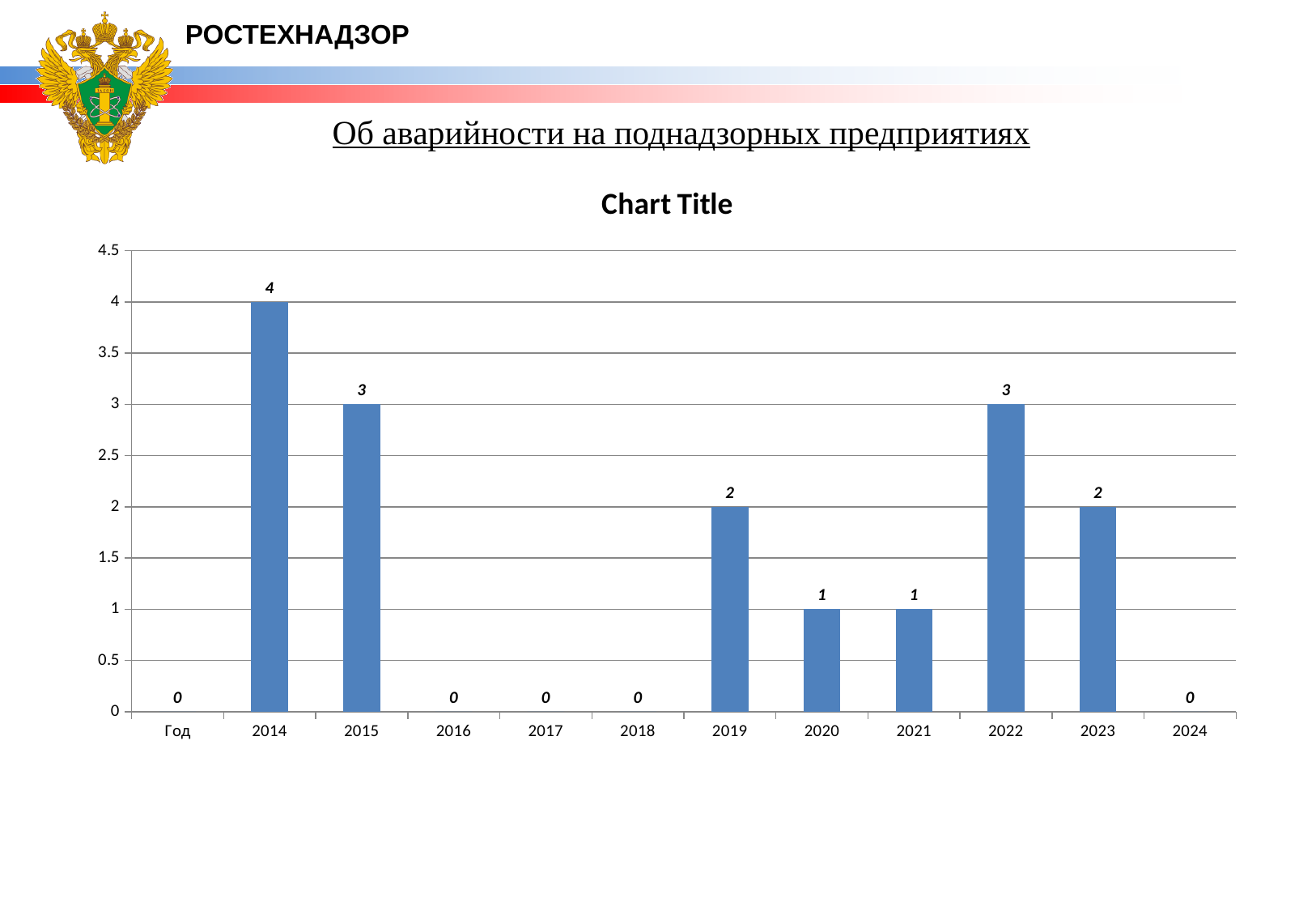
What is the difference between the values for 2014 and 2015? 1 Which year has the highest value? 2014 What is the value for 2022? 3 What is the value for 2020? 1 What is the value for 2014? 4 Which is larger, the value for 2019 or the value for 2021? 2019 What kind of chart is shown? bar chart What is the value for 2019? 2 Which is larger, the value for 2015 or the value for 2023? 2015 What is the title shown above the chart? Chart Title What is the difference between the values for 2022 and 2023? 1 How many categories are shown on the x axis? 12